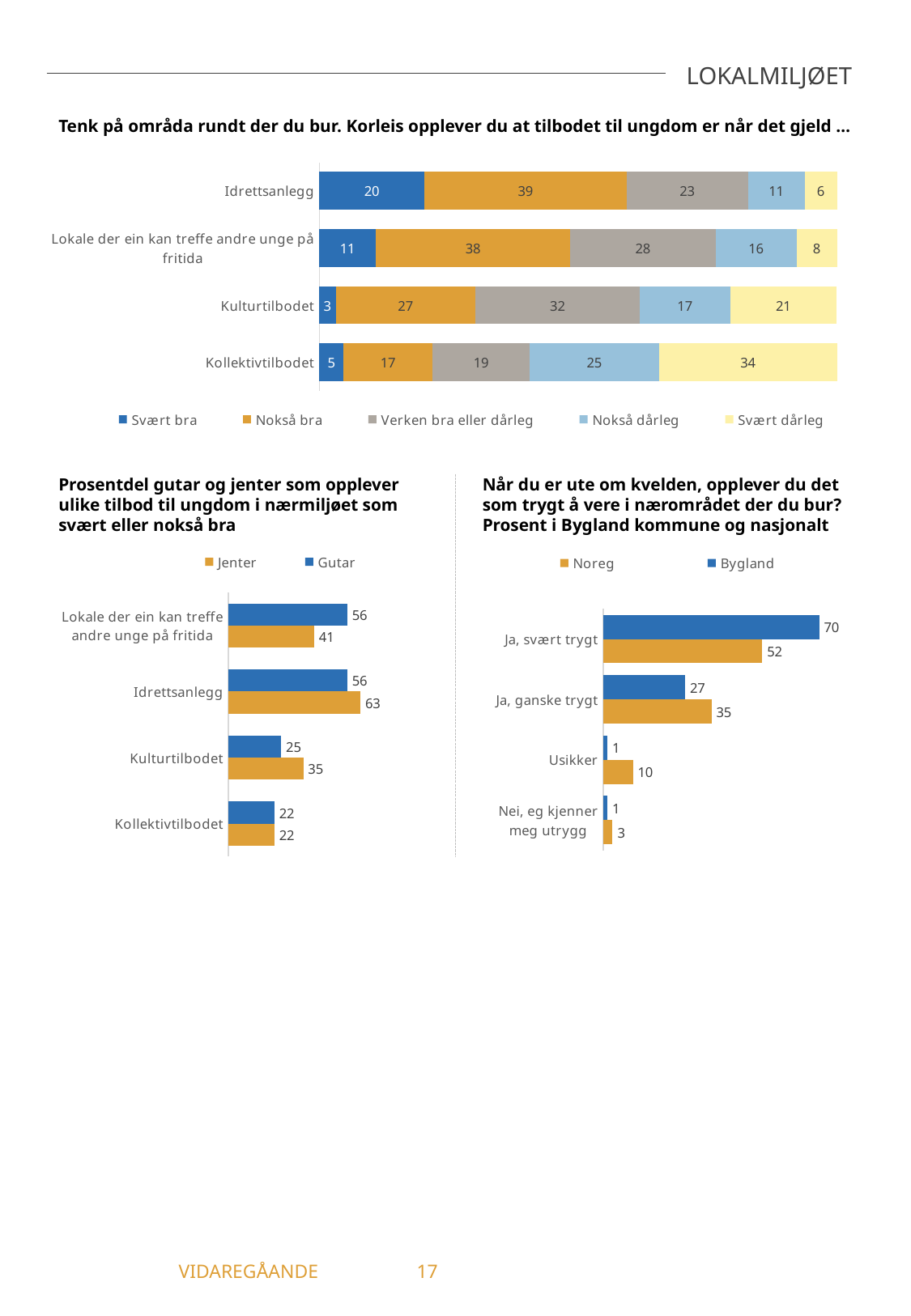
What kind of chart is the bottom-right chart ("Når du er ute om kvelden...")? Bar chart In the top chart ("Tenk på områda rundt der du bur..."), what is the total of the stacked bar for Kulturtilbodet? 100 In the bottom-left chart ("Prosentdel gutar og jenter..."), which category has the lowest Gutar value? Kollektivtilbodet In the top chart ("Tenk på områda rundt der du bur..."), what is the value of "Nokså bra" for Idrettsanlegg? 39 In the top chart ("Tenk på områda rundt der du bur..."), which category has the highest "Svært bra" value? Idrettsanlegg In the bottom-left chart ("Prosentdel gutar og jenter..."), how many categories are shown? 4 In the top chart ("Tenk på områda rundt der du bur..."), how many series does the legend list? 5 In the bottom-right chart ("Når du er ute om kvelden..."), what is the Bygland value for "Ja, svært trygt"? 70 In the top chart ("Tenk på områda rundt der du bur..."), what is the value of "Svært dårleg" for Kollektivtilbodet? 34 In the bottom-right chart ("Når du er ute om kvelden..."), which is larger for "Ja, ganske trygt": Noreg or Bygland? Noreg In the bottom-left chart ("Prosentdel gutar og jenter..."), what is the Jenter value for Idrettsanlegg? 63 In the bottom-left chart ("Prosentdel gutar og jenter..."), what is the difference between the Gutar and Jenter values for "Lokale der ein kan treffe andre unge på fritida"? 15